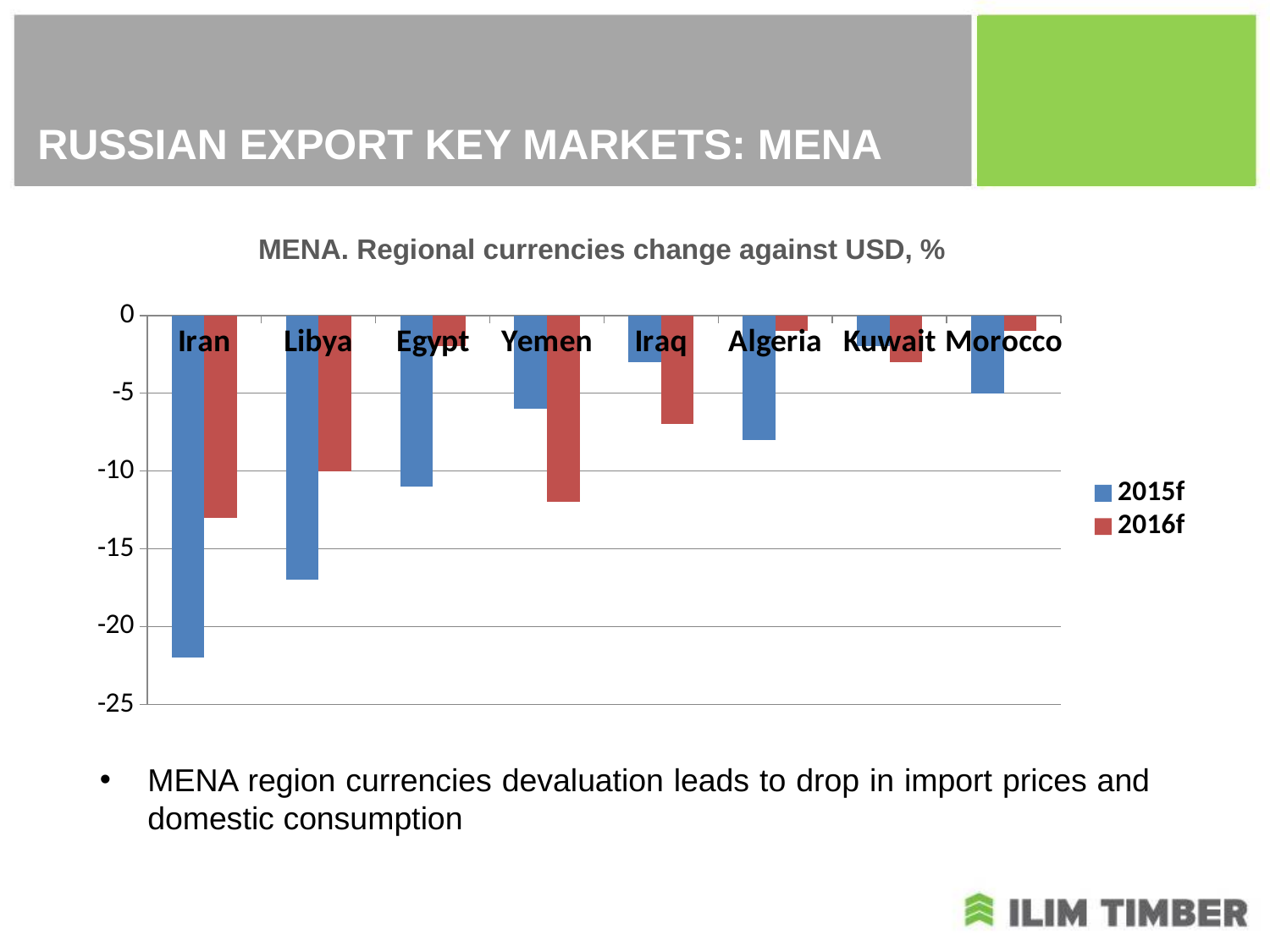
Is the value for Egypt in 2015f greater or less than -10? less Which series is shown in red in the chart? 2016f For Yemen, which series has the lower value, 2015f or 2016f? 2016f For Libya, which series has the higher value, 2015f or 2016f? 2016f How many series does the chart's legend list? 2 Is the value for Iran in 2015f greater or less than -20? less Which country has the highest (closest to zero) value for 2015f? Kuwait What kind of chart is shown on the slide? bar chart How many countries are shown on the x axis of the chart? 8 What is the title of the chart? MENA. Regional currencies change against USD, % Is the value for Iraq in 2016f greater or less than -5? less Which country has the lowest (most negative) value for 2015f? Iran